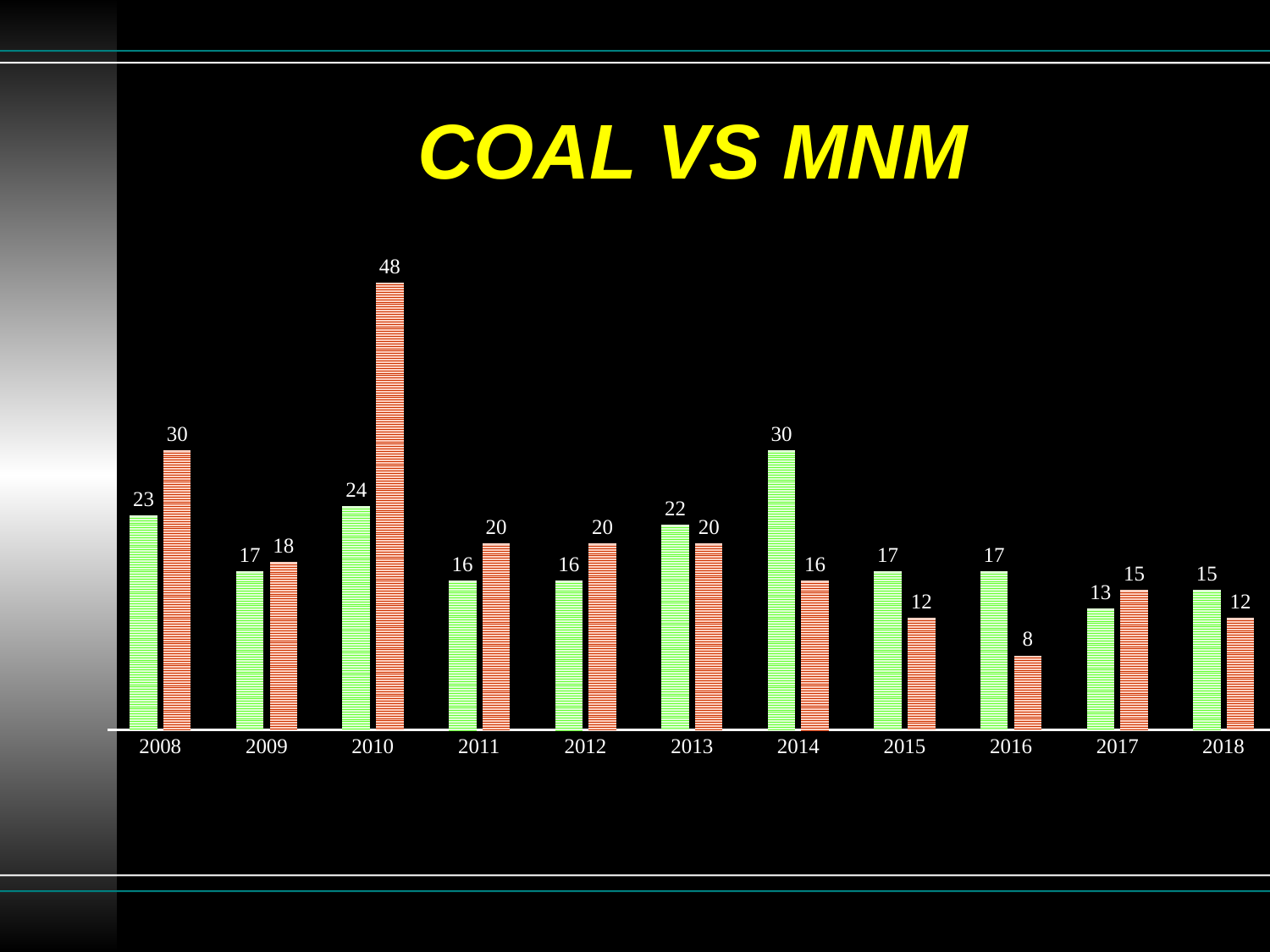
Which is larger in 2013, the green bar or the red bar? the green bar What is the value of the red bar for 2016? 8 In which year is the green bar highest? 2014 What is the value of the green bar for 2017? 13 In which year is the red bar highest? 2010 What is the value of the red bar for 2010? 48 In which year is the red bar lowest? 2016 What is the title of the chart? COAL VS MNM How many years are shown on the x axis? 11 What kind of chart is shown on the slide? bar chart What is the difference between the red bar and the green bar in 2010? 24 What is the value of the green bar for 2014? 30